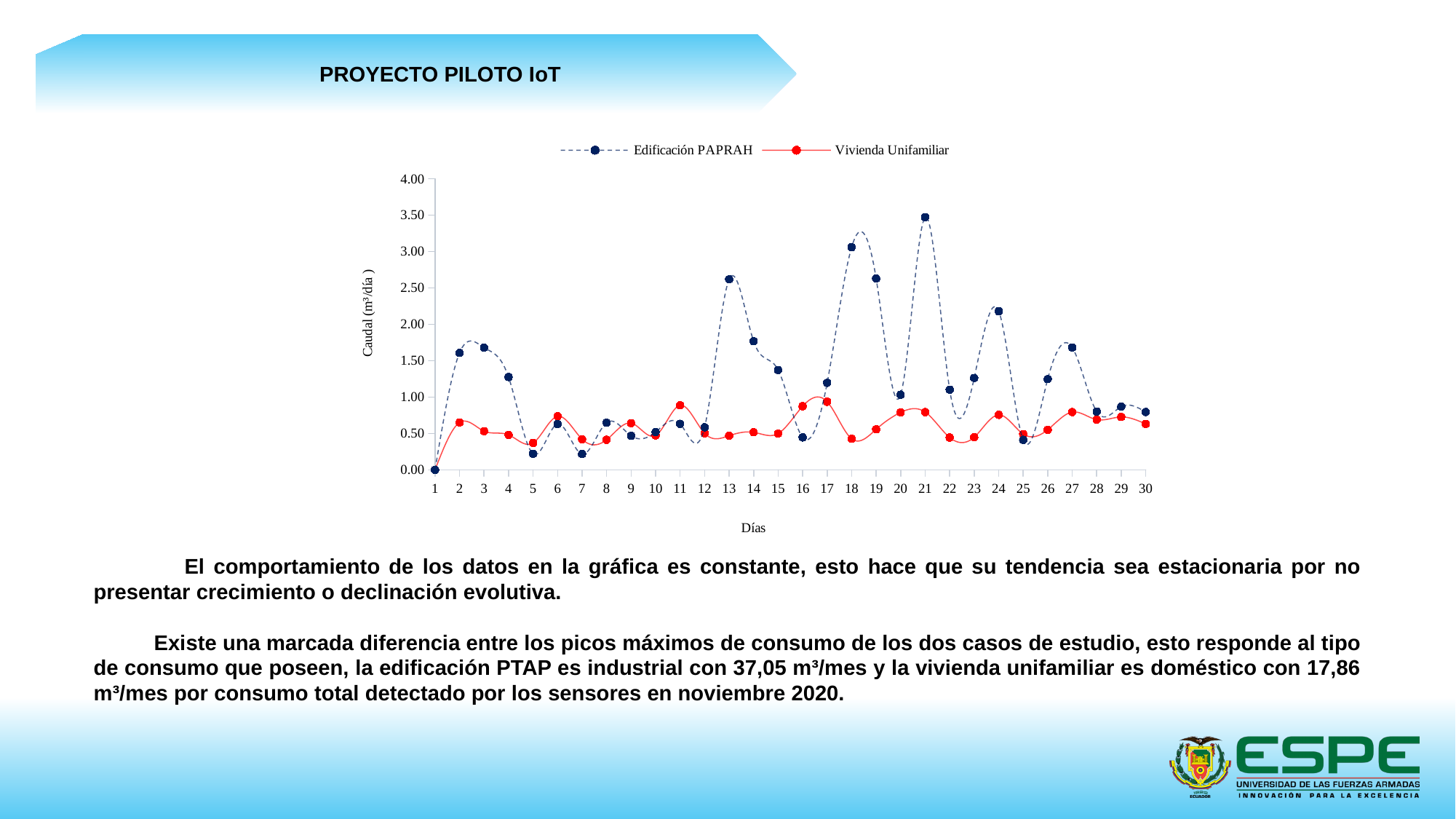
Is the value for Edificación PAPRAH on day 21 greater or less than 3.00? greater How many days are plotted along the x axis? 30 How many series does the legend list? 2 What kind of chart is shown on the slide? line chart Is the value for Edificación PAPRAH on day 13 greater or less than 2.50? greater Is the value for Vivienda Unifamiliar on day 20 greater or less than 1.00? less On day 16, which series has the larger value, Edificación PAPRAH or Vivienda Unifamiliar? Vivienda Unifamiliar On which day does the Edificación PAPRAH series reach its highest value? 21 On day 21, which series has the larger value, Edificación PAPRAH or Vivienda Unifamiliar? Edificación PAPRAH What is the label of the x axis of the chart? Días On which day does the Edificación PAPRAH series have its lowest value? 1